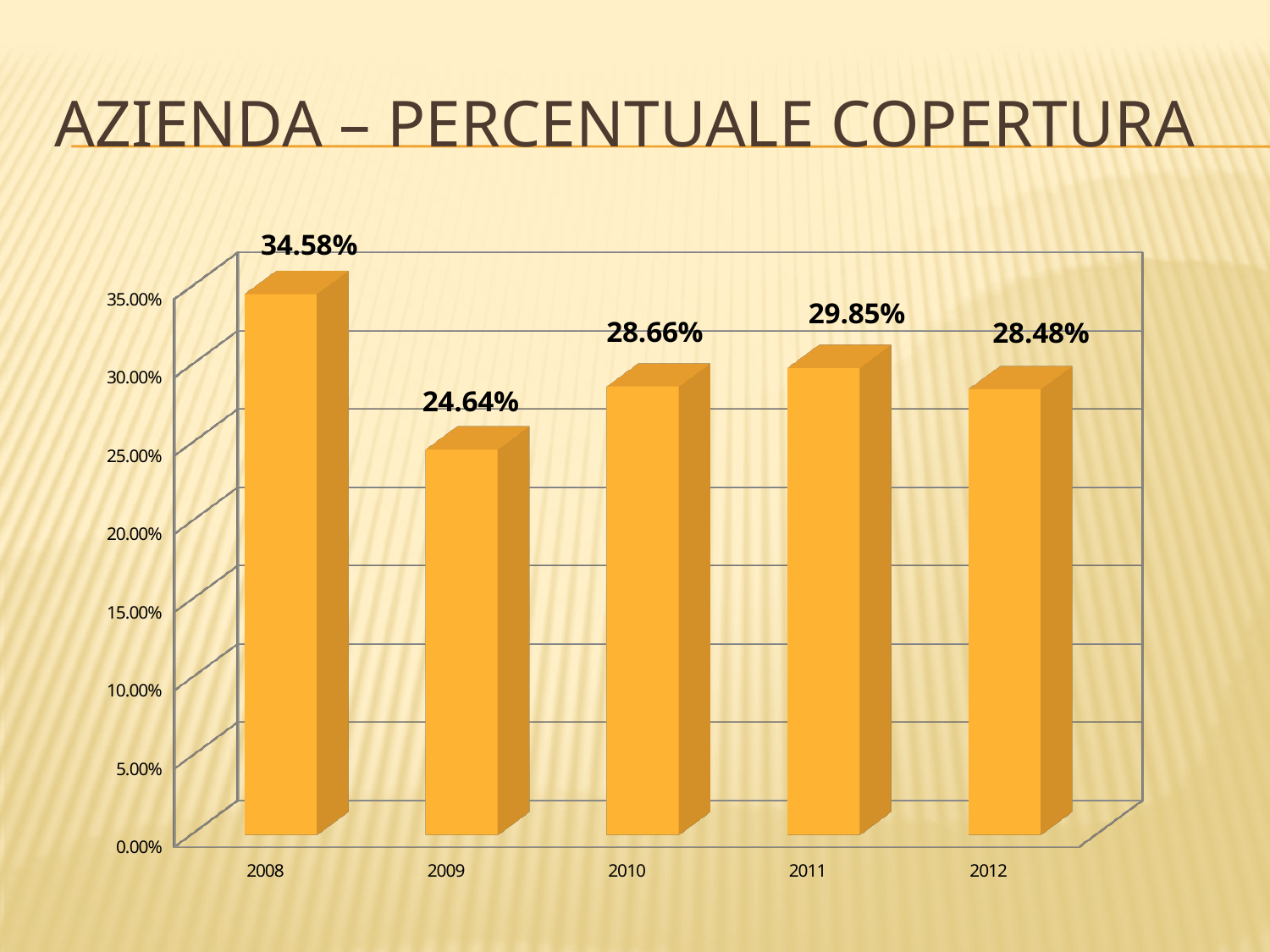
What is the title of the slide? AZIENDA – PERCENTUALE COPERTURA Which year has the highest value? 2008 What is the difference between the values for 2008 and 2009? 9.94% What kind of chart is shown on the slide? Bar chart What is the value for 2011? 29.85% Which is larger, the value for 2010 or the value for 2012? 2010 Which year has the lowest value? 2009 What is the value for 2012? 28.48% How many years are shown on the x axis? 5 What is the value for 2009? 24.64% What is the difference between the values for 2011 and 2010? 1.19% What is the value for 2008? 34.58%